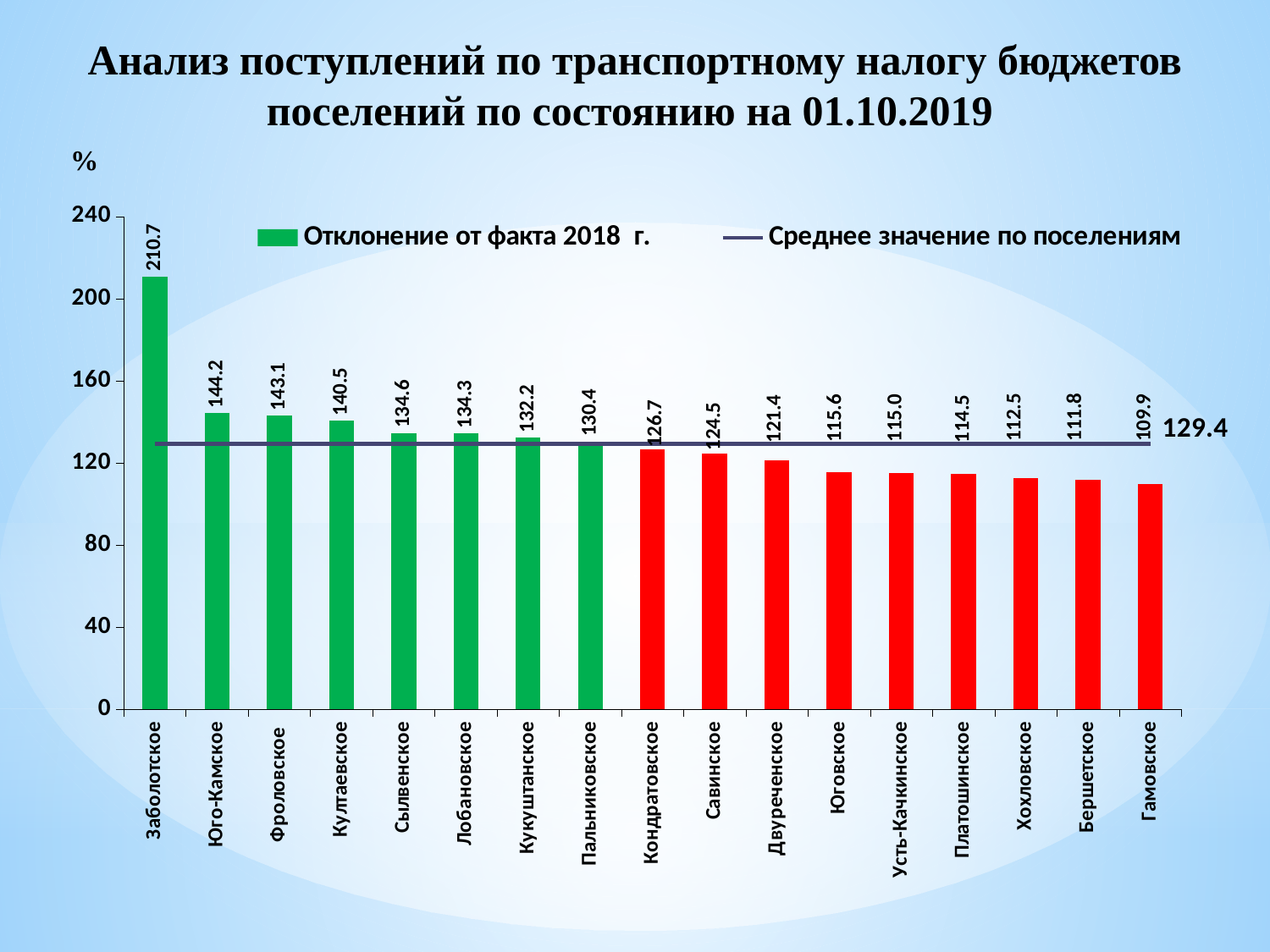
How many categories (settlements) are shown on the x axis? 17 What is the value of the average line (Среднее значение по поселениям) shown on the chart? 129.4 What kind of chart is shown on the slide? bar chart What is the value for Гамовское? 109.9 What is the value for Заболотское? 210.7 What is the value for Кондратовское? 126.7 Which category has the highest value? Заболотское Which category has the lowest value? Гамовское Is the value for Югoвское greater or less than 120? less What is the difference between the values for Заболотское and Юго-Камское? 66.5 How many series does the legend list? 2 Which is larger, the value for Фроловское or the value for Савинское? Фроловское